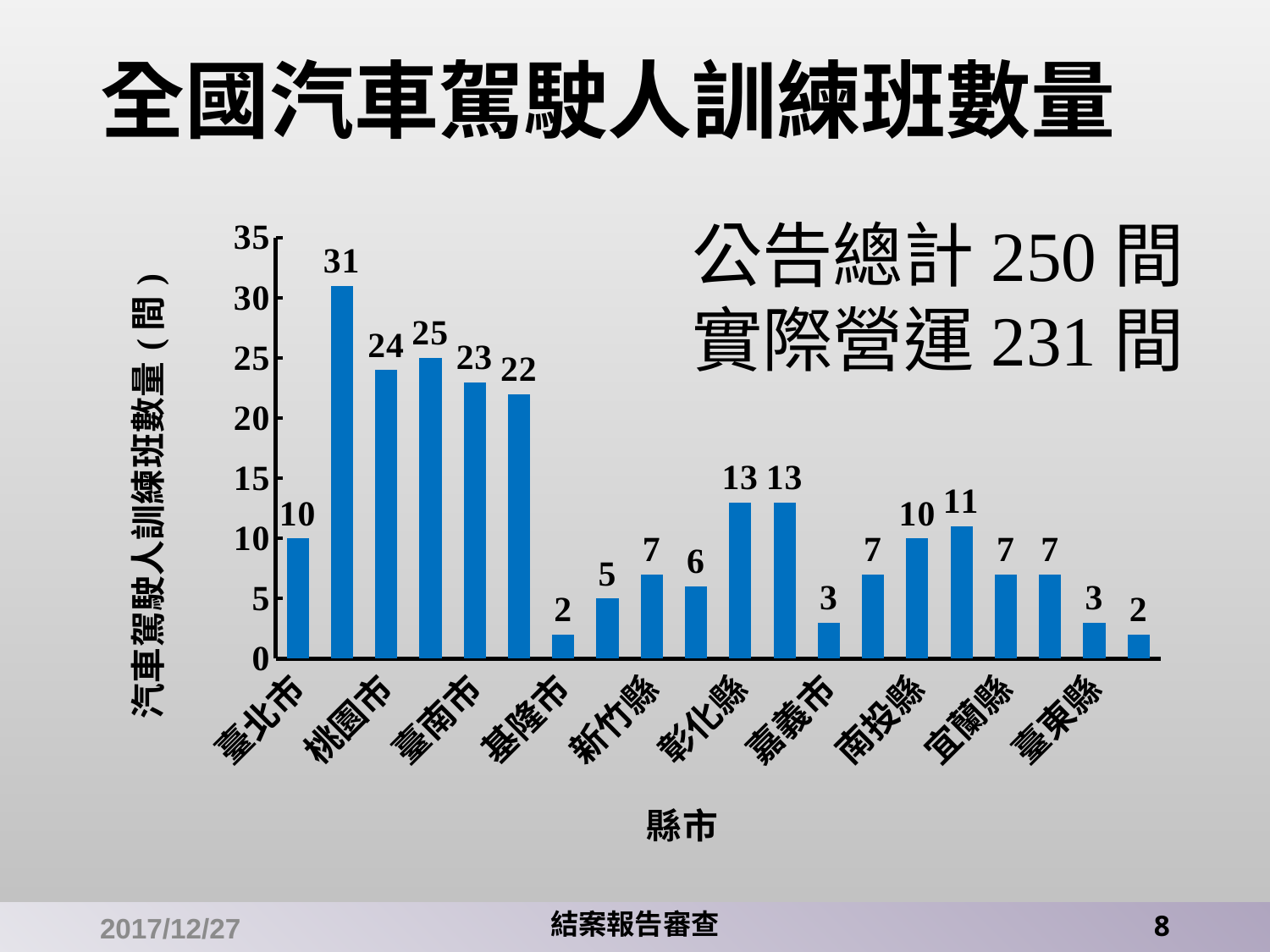
What is the title of the slide's chart? 全國汽車駕駛人訓練班數量 What is the highest value shown by any bar in the chart? 31 How many bars are plotted in the chart? 20 What is the maximum value shown on the y axis? 35 What is the label of the x axis? 縣市 What is the lowest value shown by any bar in the chart? 2 What is the value for 基隆市? 2 What is the value for 臺北市? 10 What is the difference between the highest bar (31) and the value for 臺北市 (10)? 21 Which is larger, the value for 臺北市 or the value for 基隆市? 臺北市 What kind of chart is shown on the slide? bar chart Is the value of the tallest bar greater or less than 30? greater